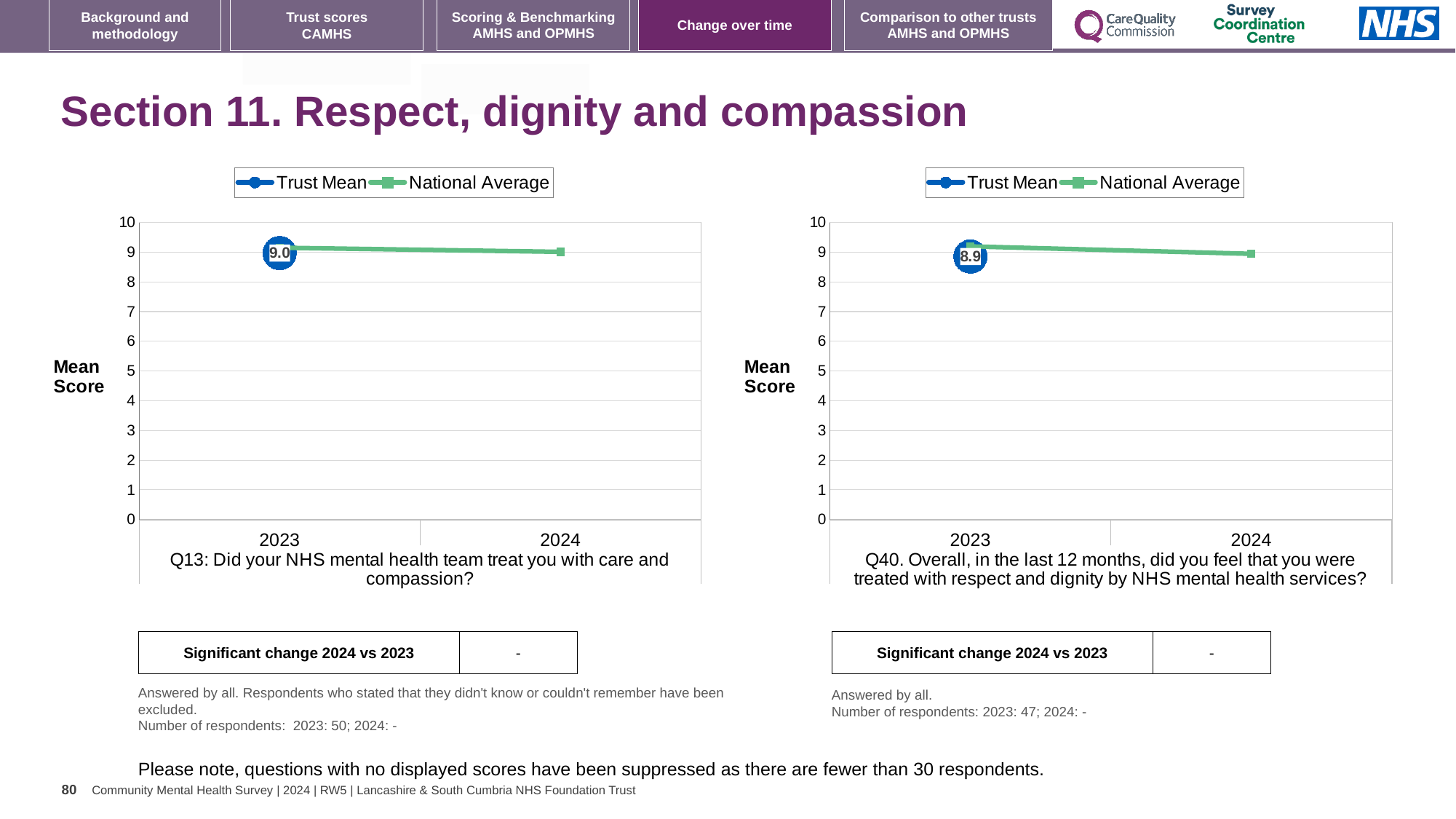
In the right chart (Q40), is the Trust Mean value for 2023 greater or less than 9? less In the left chart (Q13), is the National Average value for 2024 greater or less than 5? greater What is the highest value shown on the y axis of the right chart (Q40)? 10 How many years are shown on the x axis of the left chart (Q13)? 2 In the right chart (Q40), is the National Average value for 2023 greater or less than 8? greater What kind of chart is the right chart (Q40)? Line chart What are the two series named in the legend of the right chart (Q40)? Trust Mean and National Average Which of the two charts shows the higher Trust Mean score for 2023, Q13 or Q40? Q13 What is the y-axis label on the left chart (Q13)? Mean Score In the right chart (Q40), what is the Trust Mean score for 2023? 8.9 How many series does the legend of the left chart (Q13) list? 2 In the left chart (Q13), what is the Trust Mean score for 2023? 9.0